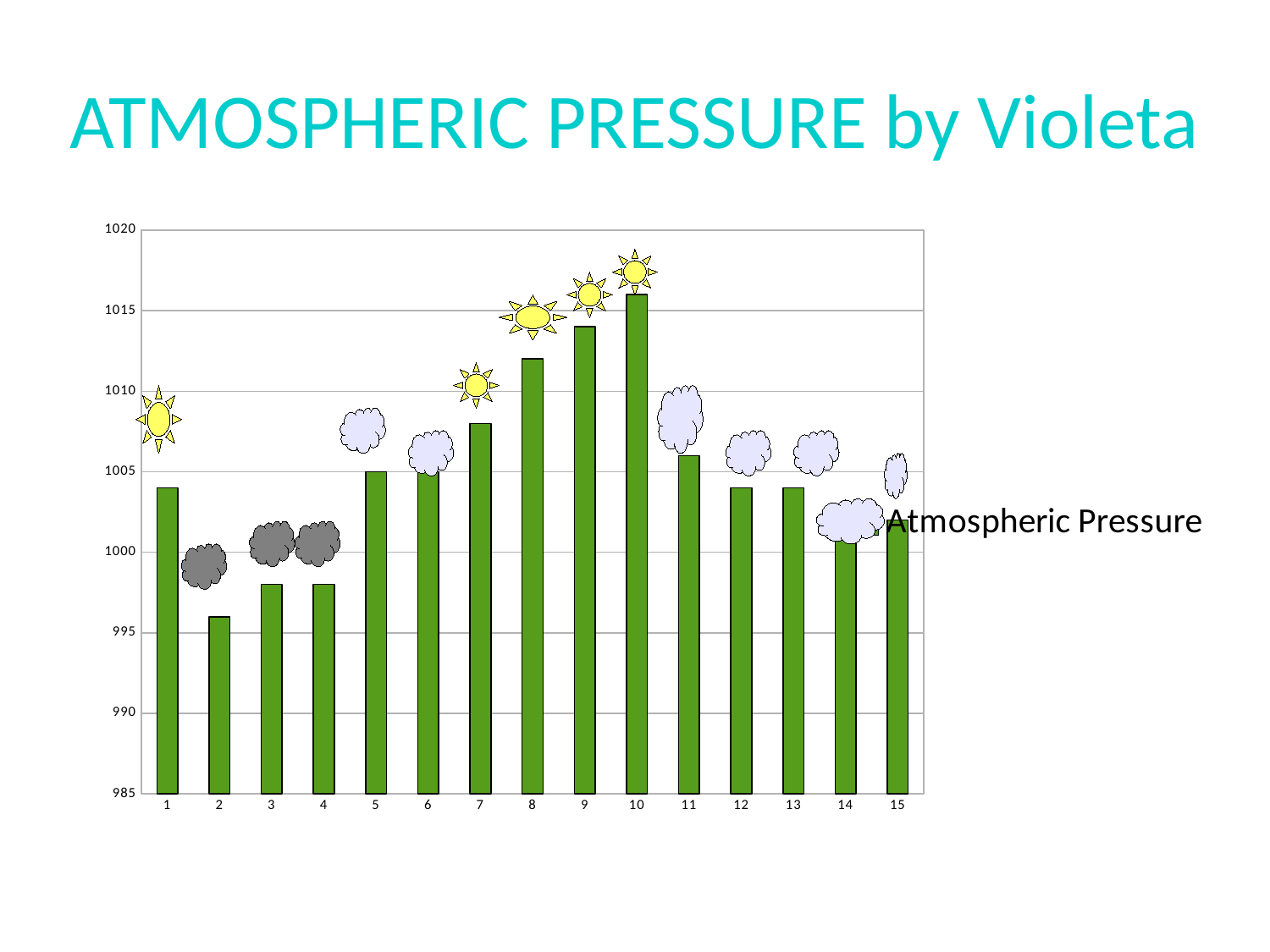
What is the name of the series shown in the legend? Atmospheric Pressure Is the value for category 10 greater or less than 1015? greater Which is larger, the value for category 9 or the value for category 3? 9 Which category has the highest atmospheric pressure? 10 Do the values rise or fall from category 10 to category 15? fall Which category has the lowest atmospheric pressure? 2 How many bars (categories) are plotted on the chart? 15 Is the value for category 2 greater or less than 1000? less Is the value for category 14 greater or less than 1005? less How many series does the legend list? 1 What kind of chart is shown on the slide? bar chart